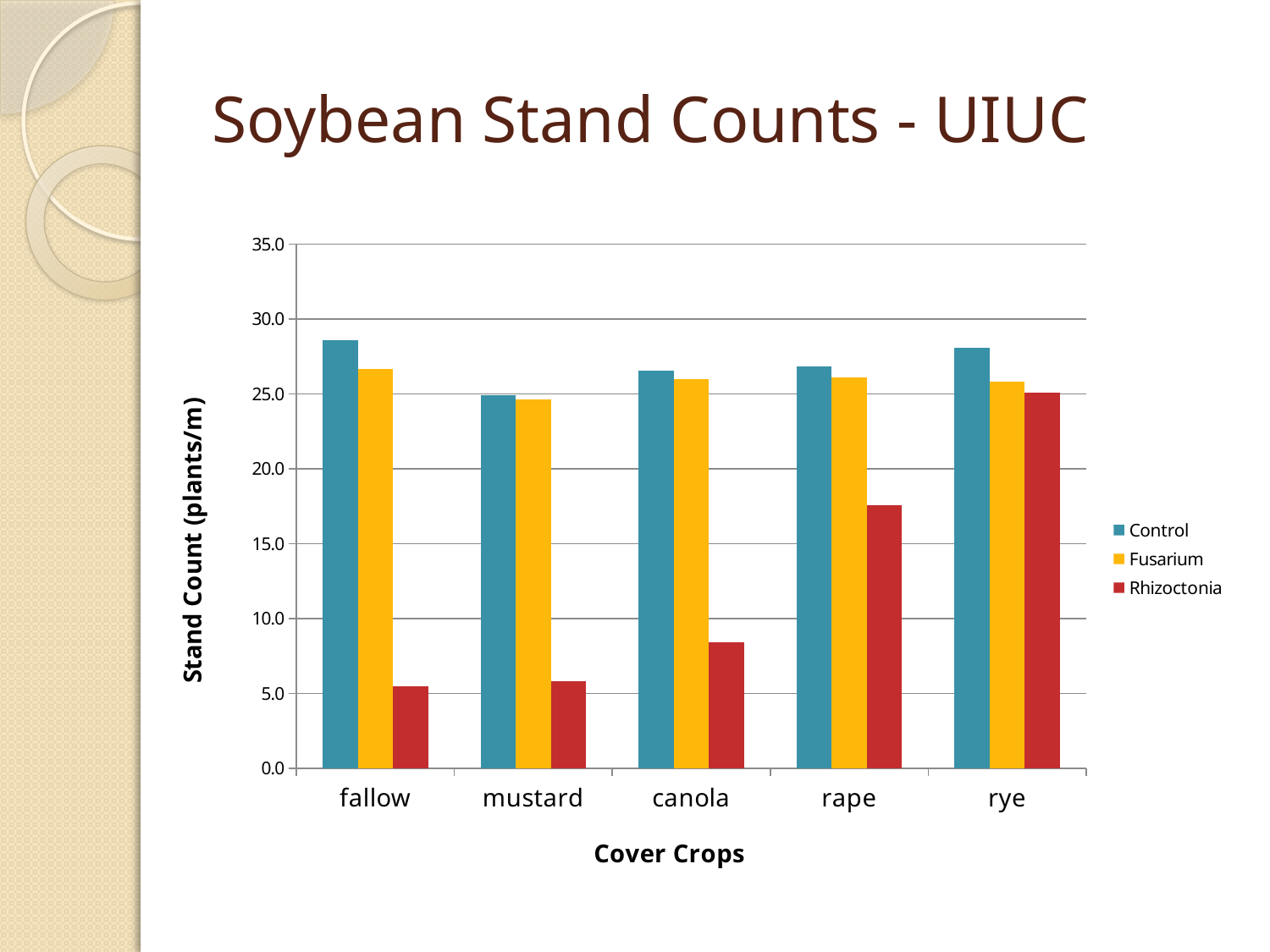
Is the Rhizoctonia value for rape greater or less than 15.0? greater What is the title of the chart? Soybean Stand Counts - UIUC Which cover crop has the lowest Control stand count? mustard How many series does the legend list? 3 Which cover crop has the highest Rhizoctonia stand count? rye What is the label of the y axis? Stand Count (plants/m) Do the Rhizoctonia values rise or fall moving from fallow to rye along the x axis? rise How many cover crop categories are shown on the x axis? 5 Is the Rhizoctonia value for fallow greater or less than 10.0? less Is the Control value for fallow greater or less than 25.0? greater What type of chart is shown on the slide? bar chart Which is larger for rape: the Control value or the Rhizoctonia value? Control